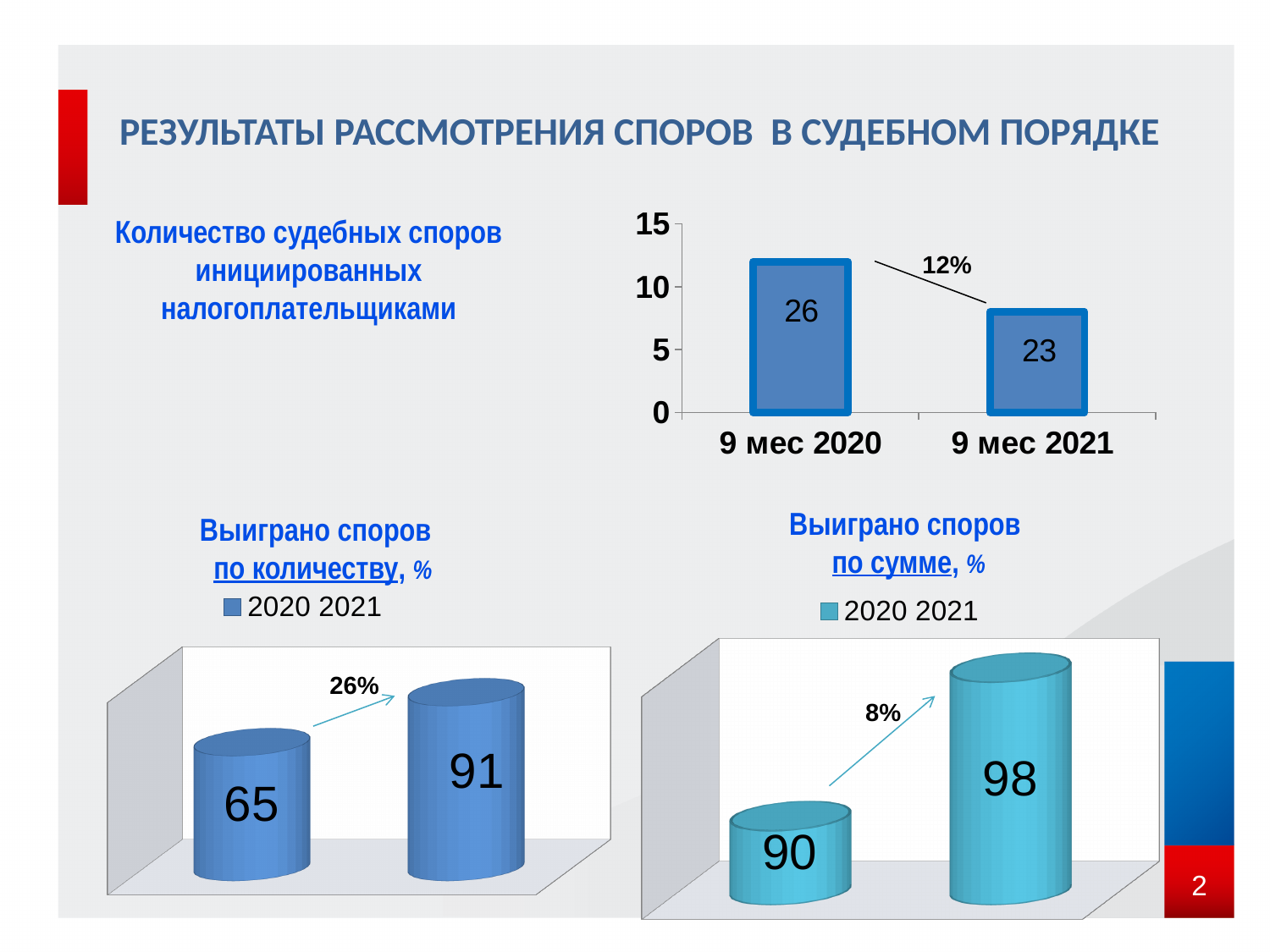
In the chart 'Количество судебных споров инициированных налогоплательщиками', do the values rise or fall from 9 мес 2020 to 9 мес 2021? fall In the chart 'Выиграно споров по количеству, %', what is the difference between the 2021 and 2020 values? 26 In the chart 'Выиграно споров по количеству, %', what is the value for 2021? 91 In the chart 'Выиграно споров по количеству, %', what is the value for 2020? 65 In the chart 'Выиграно споров по сумме, %', which year has the higher value, 2020 or 2021? 2021 In the chart 'Количество судебных споров инициированных налогоплательщиками', what is the difference between the 9 мес 2020 and 9 мес 2021 values? 3 What kind of chart is 'Выиграно споров по сумме, %'? bar chart In the chart 'Количество судебных споров инициированных налогоплательщиками', what percentage change is annotated between the two bars? 12% In the chart 'Количество судебных споров инициированных налогоплательщиками', what is the value for 9 мес 2020? 26 In the chart 'Количество судебных споров инициированных налогоплательщиками', what is the value for 9 мес 2021? 23 In the chart 'Выиграно споров по сумме, %', what is the value for 2021? 98 In the chart 'Выиграно споров по сумме, %', what is the value for 2020? 90